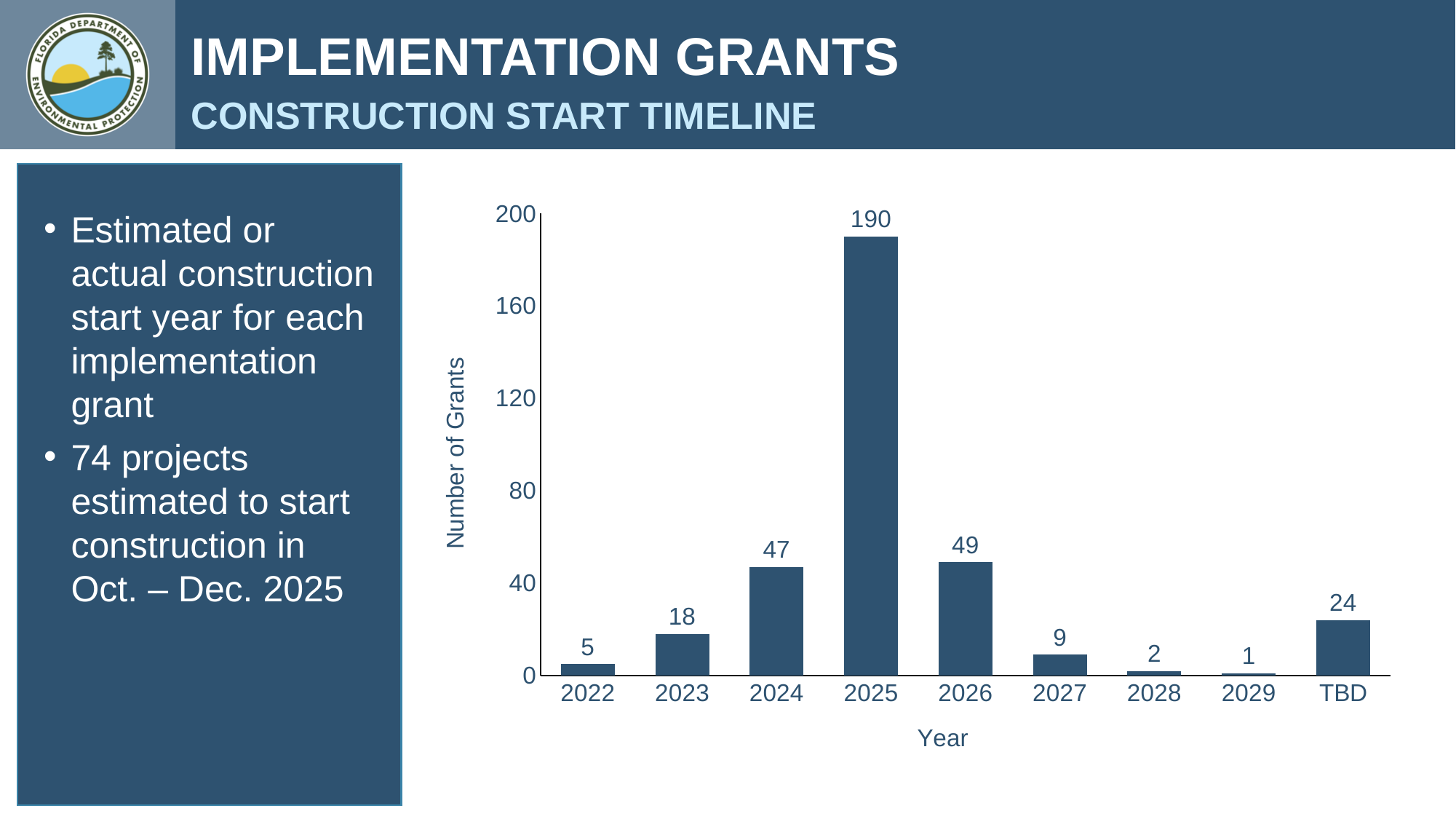
How many categories are shown on the x axis? 9 Which has more grants, 2024 or 2026? 2026 What kind of chart is shown on the slide? Bar chart Which category has the lowest number of grants? 2029 How many grants are shown for 2025? 190 What is the difference in number of grants between 2023 and 2022? 13 Which year has the highest number of grants? 2025 What is the number of grants for 2024? 47 Is the value for 2025 greater or less than 160? greater How many grants have a construction start year of TBD? 24 What is the difference in number of grants between 2025 and 2026? 141 What is the label of the y axis? Number of Grants